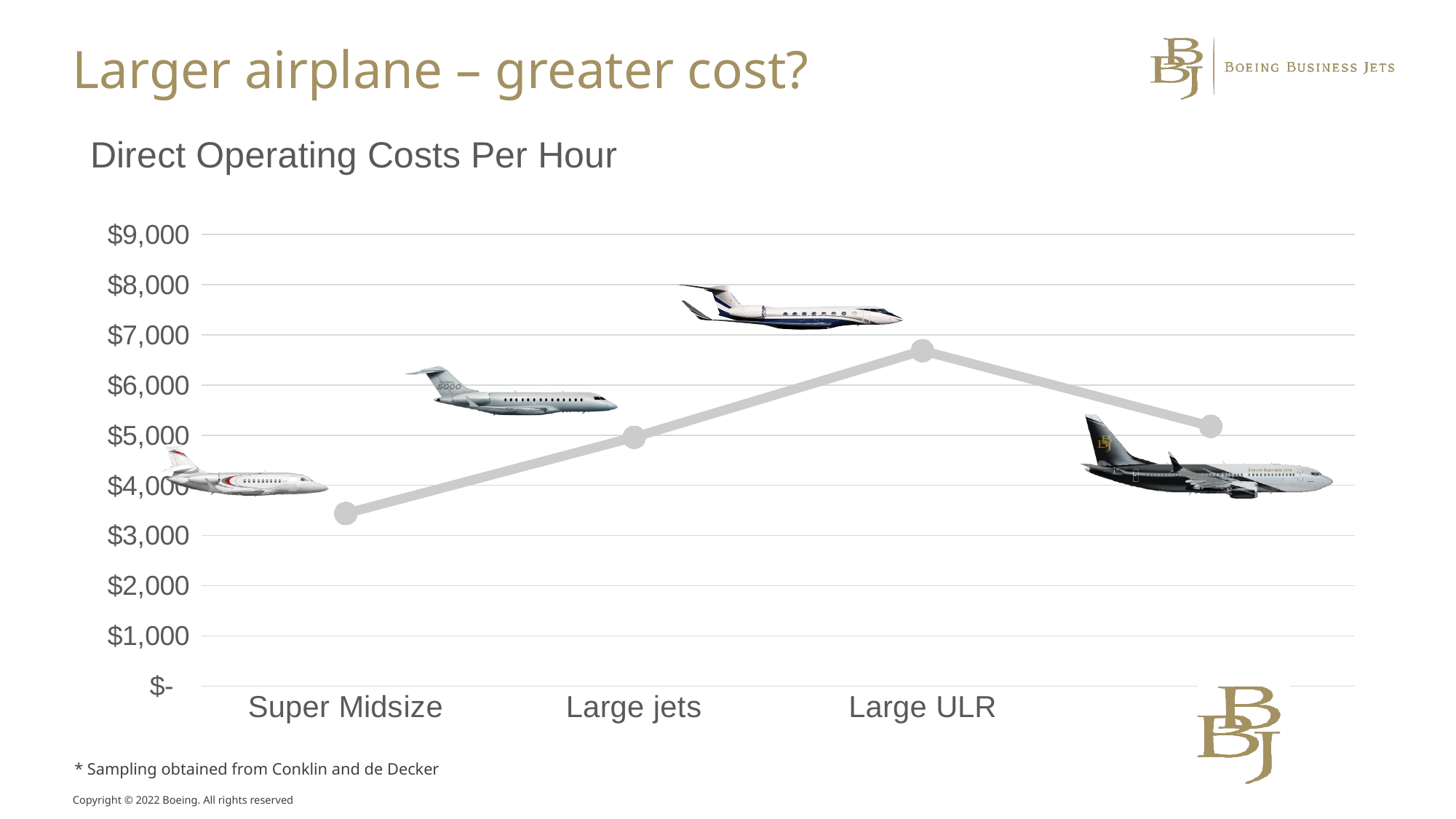
Is the value for Large ULR greater or less than $6,000? greater Is the value for Super Midsize greater or less than $4,000? less Do the values rise or fall from Super Midsize to Large ULR? rise Which is larger, the value for Large jets or the value for Large ULR? Large ULR Is the value for Large jets greater or less than $4,000? greater Which is larger, the value for Super Midsize or the value for Large jets? Large jets Which category has the lowest direct operating cost per hour? Super Midsize What is the title of the chart? Direct Operating Costs Per Hour Which labelled category has the highest direct operating cost per hour? Large ULR What kind of chart is shown on the slide? Line chart